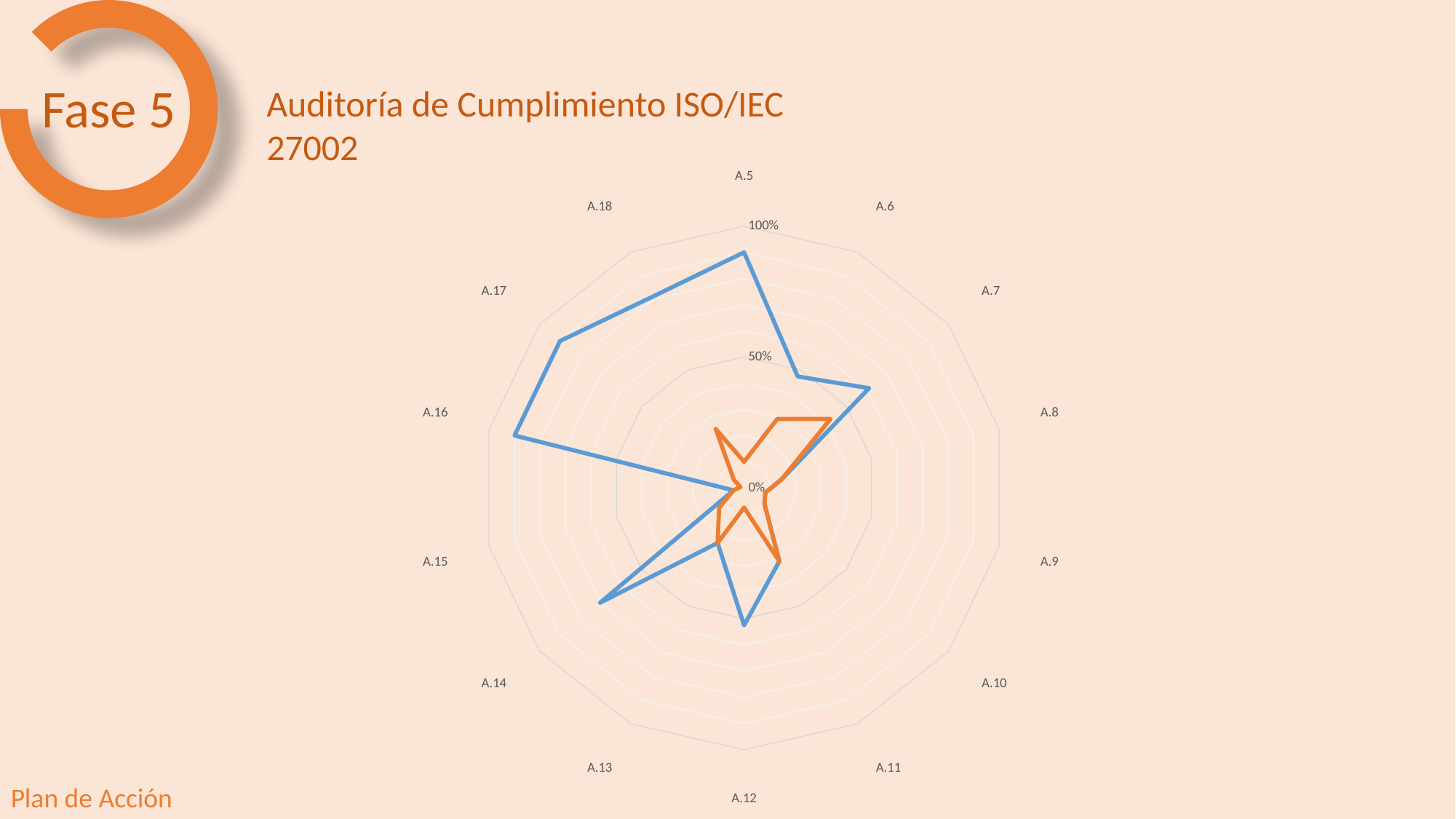
At A.17, which series has the larger value, blue or orange? Blue How many data series (lines) are plotted on the radar chart? 2 What kind of chart is shown on the slide? Radar chart Is the blue series value for A.14 greater or less than 50%? greater How many categories (axes) does the radar chart have? 14 Is the orange series value for A.5 greater or less than 50%? less At A.16, which series has the larger value, blue or orange? Blue What is the highest percentage tick shown on the radar chart's axis? 100% Is the orange series value for A.12 greater or less than 50%? less What is the title of the chart on the slide? Auditoría de Cumplimiento ISO/IEC 27002